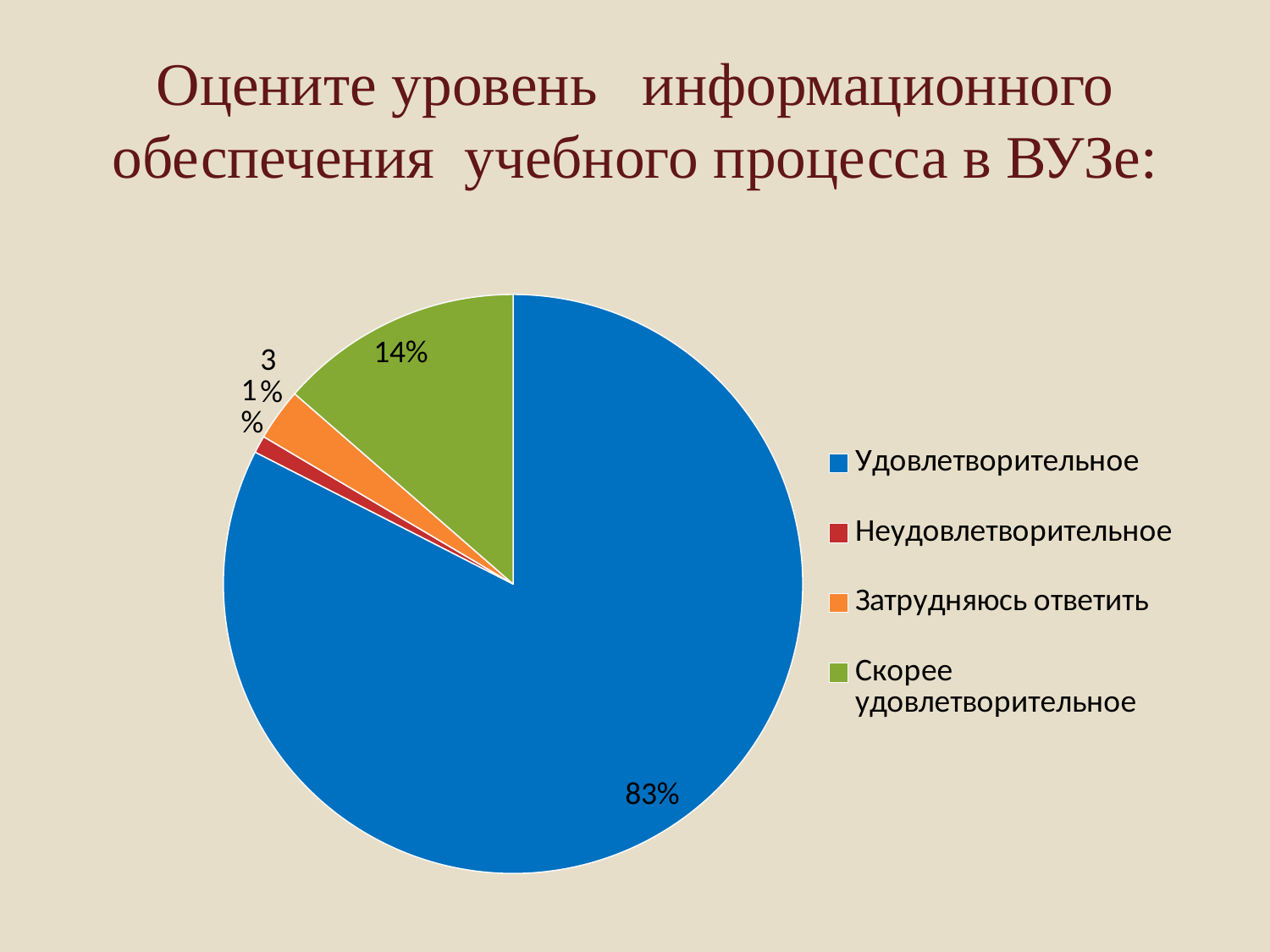
What colour is the slice for "Скорее удовлетворительное"? green What is the combined share of "Удовлетворительное" and "Скорее удовлетворительное"? 97% Which is larger: the share of "Скорее удовлетворительное" or the share of "Затрудняюсь ответить"? Скорее удовлетворительное What is the difference between the shares of "Удовлетворительное" and "Скорее удовлетворительное"? 69% What share of the pie does "Скорее удовлетворительное" take? 14% How many categories does the pie chart have? 4 Which category has the smallest slice of the pie? Неудовлетворительное What kind of chart is shown on the slide? pie chart What share of the pie does "Неудовлетворительное" take? 1% What share of the pie does "Затрудняюсь ответить" take? 3% Which category has the largest slice of the pie? Удовлетворительное What share of the pie does "Удовлетворительное" take? 83%